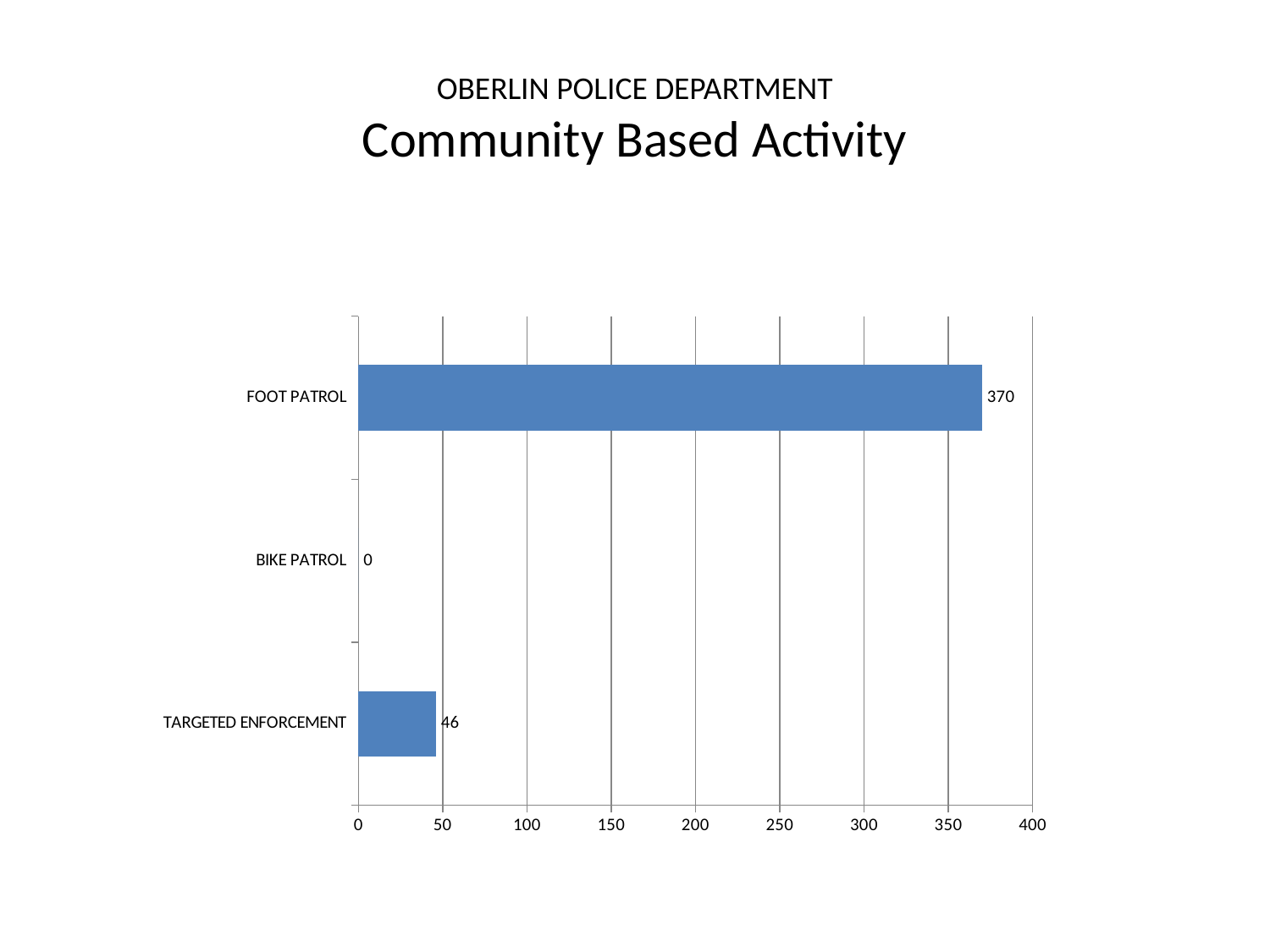
How many categories are shown in the chart? 3 Which category has the highest value? FOOT PATROL What is the value for FOOT PATROL? 370 Is the value for TARGETED ENFORCEMENT greater or less than 50? less What kind of chart is shown on the slide? bar chart What is the value for TARGETED ENFORCEMENT? 46 Which category has the lowest value? BIKE PATROL What is the title of the slide? OBERLIN POLICE DEPARTMENT Community Based Activity What is the difference between the values for FOOT PATROL and TARGETED ENFORCEMENT? 324 What is the value for BIKE PATROL? 0 Which is larger, the value for TARGETED ENFORCEMENT or the value for BIKE PATROL? TARGETED ENFORCEMENT Is the value for FOOT PATROL greater or less than 350? greater